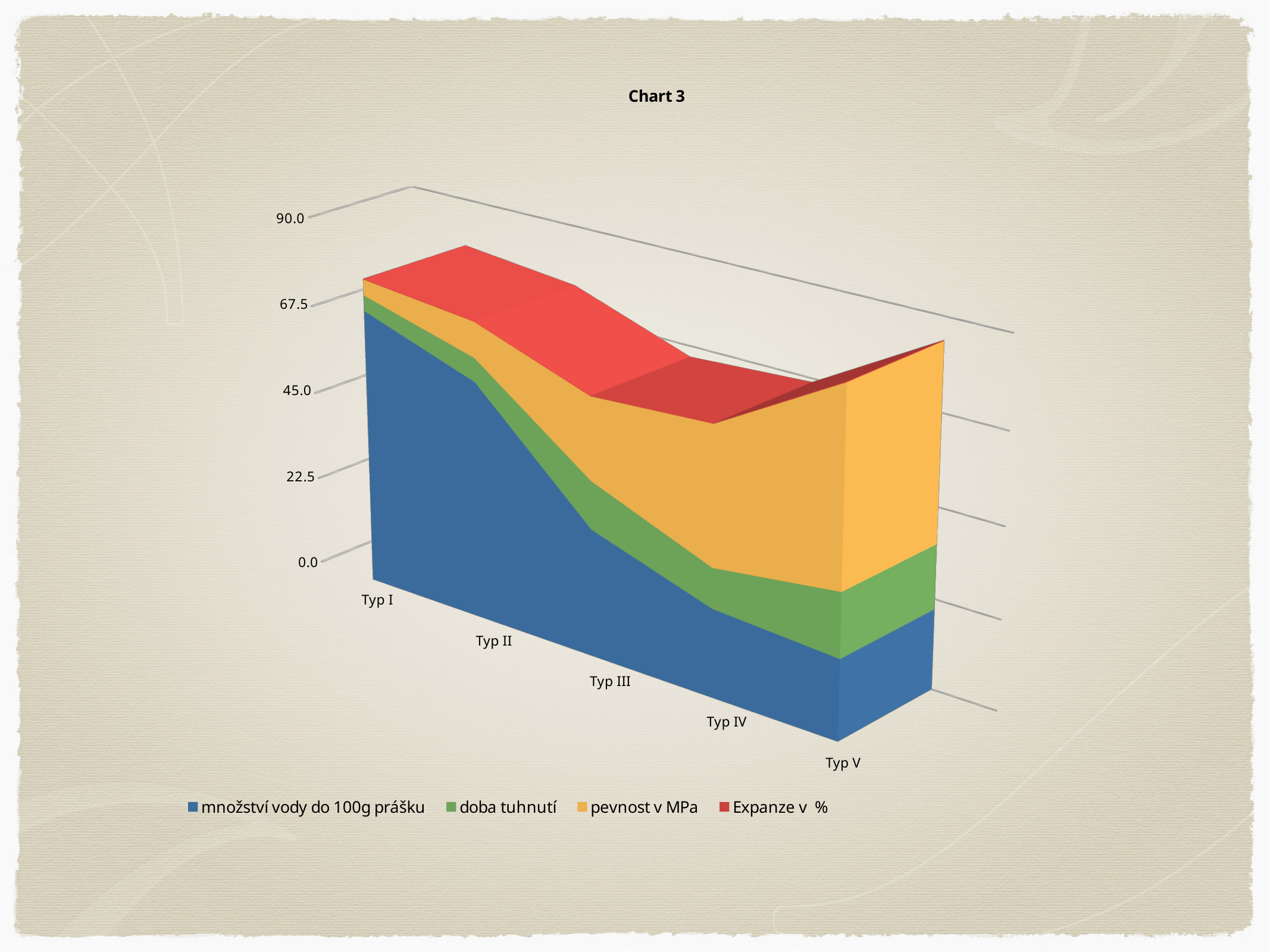
Is the value of 'množství vody do 100g prášku' for Typ I greater or less than 45.0? greater Which is larger, the value of 'množství vody do 100g prášku' for Typ I or for Typ V? Typ I Does the value of 'množství vody do 100g prášku' rise or fall from Typ I to Typ V? fall How many series does the legend list? 4 Which category has the lowest value for 'množství vody do 100g prášku'? Typ V How many categories are shown on the x axis of the chart? 5 What kind of chart is shown on the slide? area chart Which category has the highest value for 'množství vody do 100g prášku'? Typ I What is the title of the chart? Chart 3 Which series is shown in red in the chart? Expanze v %